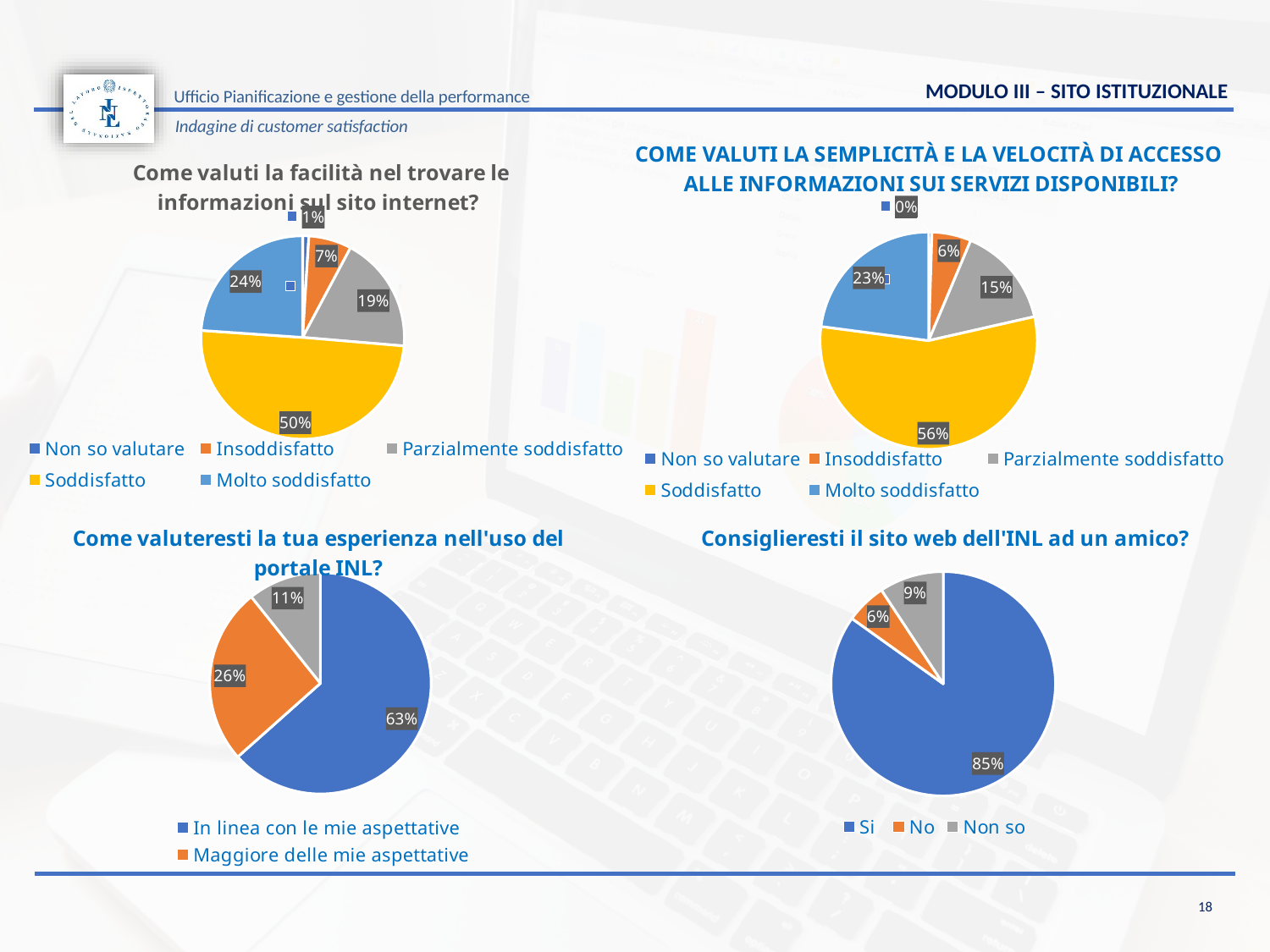
In the chart 'Come valuteresti la tua esperienza nell'uso del portale INL?', what percentage is shown for 'In linea con le mie aspettative'? 63% What kind of chart is 'Consiglieresti il sito web dell'INL ad un amico?'? Pie chart In the chart 'Come valuti la semplicità e la velocità di accesso alle informazioni sui servizi disponibili?', which category has the largest share? Soddisfatto In the chart 'Come valuti la facilità nel trovare le informazioni sul sito internet?', what percentage is shown for Soddisfatto? 50% In the chart 'Come valuti la facilità nel trovare le informazioni sul sito internet?', what percentage is shown for Molto soddisfatto? 24% In the chart 'Come valuteresti la tua esperienza nell'uso del portale INL?', what percentage is shown for 'Maggiore delle mie aspettative'? 26% In the chart 'Consiglieresti il sito web dell'INL ad un amico?', what percentage answered Si? 85% How many entries does the legend of the chart 'Come valuti la semplicità e la velocità di accesso alle informazioni sui servizi disponibili?' list? 5 In the chart 'Come valuti la semplicità e la velocità di accesso alle informazioni sui servizi disponibili?', what percentage is shown for Parzialmente soddisfatto? 15% In the chart 'Come valuti la facilità nel trovare le informazioni sul sito internet?', which category has the smallest share? Non so valutare In the chart 'Come valuti la semplicità e la velocità di accesso alle informazioni sui servizi disponibili?', what is the difference between Soddisfatto and Molto soddisfatto? 33 percentage points In the chart 'Consiglieresti il sito web dell'INL ad un amico?', which is larger, No or Non so? Non so